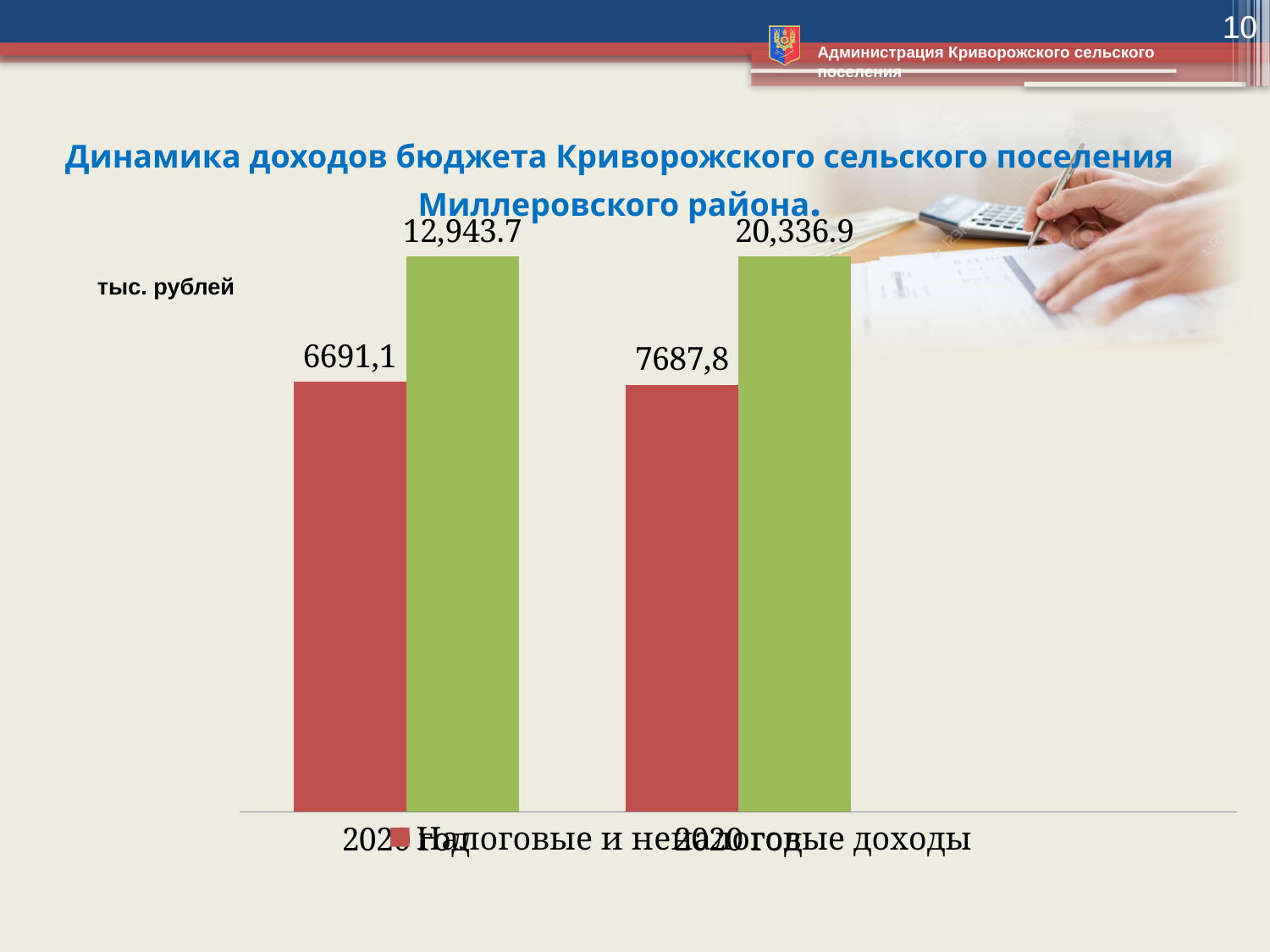
Which bar on the chart has the highest value? The green bar for 2020 год (20,336.9) What is the value of the green bar for 2020 год? 20,336.9 What is the value of the red bar (Налоговые и неналоговые доходы) for 2020 год? 7687,8 What is the value of the red bar (Налоговые и неналоговые доходы) in the left group of bars? 6691,1 Do the green bars rise or fall from the left group to the right group? Rise What unit is indicated for the values on the chart? тыс. рублей What is the value of the green bar in the left group of bars? 12,943.7 How many groups of bars (categories) are shown on the chart? 2 Is the red bar (Налоговые и неналоговые доходы) larger in the left group or in the 2020 год group? 2020 год By how much does the red bar for 2020 год exceed the red bar in the left group? 996,7 Which bar on the chart has the lowest value? The red bar in the left group (6691,1) What type of chart is shown on the slide? Bar chart